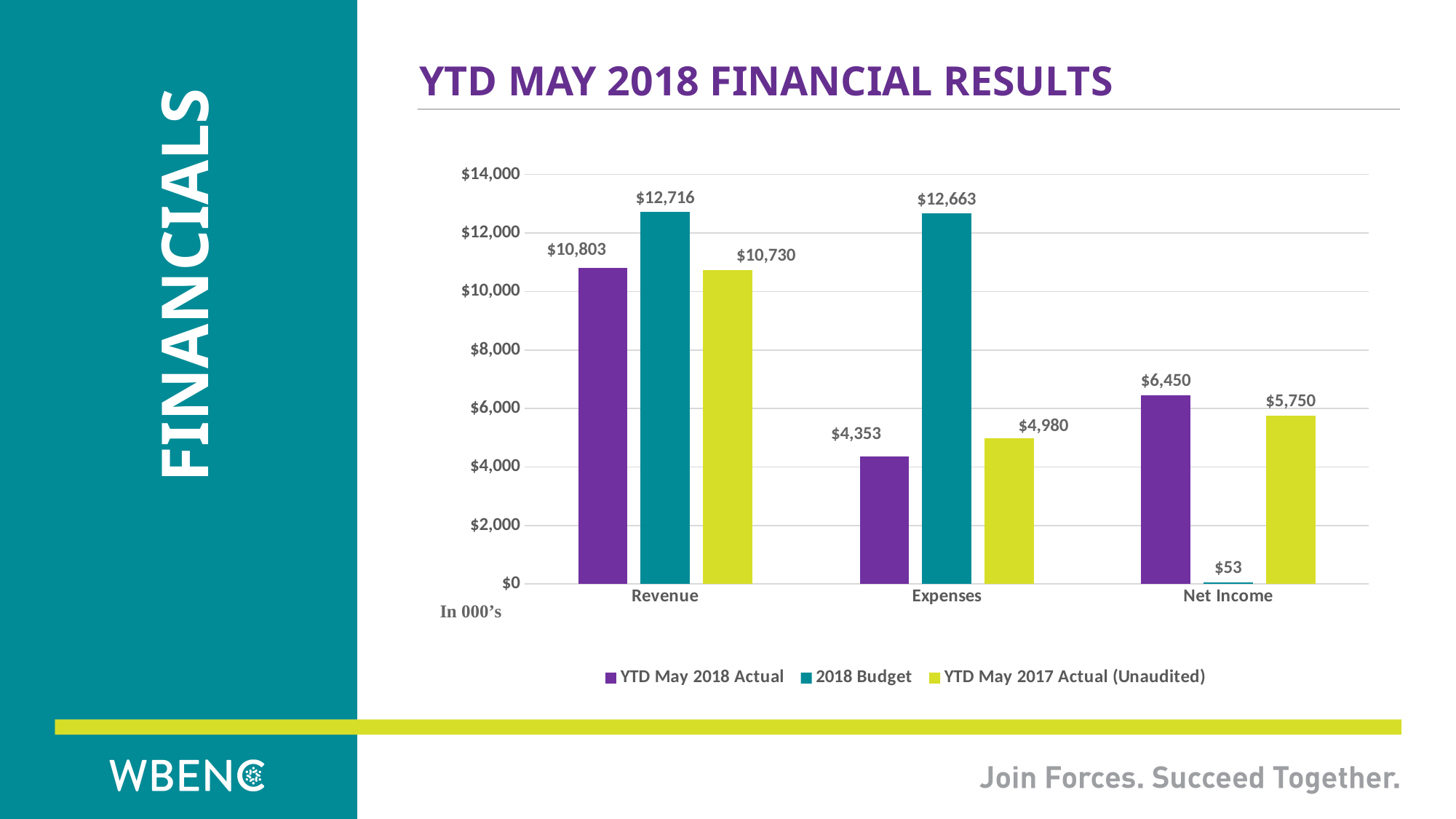
What is the difference between the YTD May 2018 Actual and the YTD May 2017 Actual (Unaudited) for Net Income? $700 What is the difference between the 2018 Budget and the YTD May 2018 Actual for Revenue? $1,913 Which is larger for Expenses: the YTD May 2018 Actual or the YTD May 2017 Actual (Unaudited)? YTD May 2017 Actual (Unaudited) What is the 2018 Budget value for Net Income? $53 How many series does the legend list? 3 What kind of chart is shown on the slide? Bar chart What is the YTD May 2017 Actual (Unaudited) value for Net Income? $5,750 Which category has the highest YTD May 2018 Actual value? Revenue What is the 2018 Budget value for Expenses? $12,663 Which category has the lowest 2018 Budget value? Net Income How many categories are shown on the x axis? 3 What is the YTD May 2018 Actual value for Revenue? $10,803